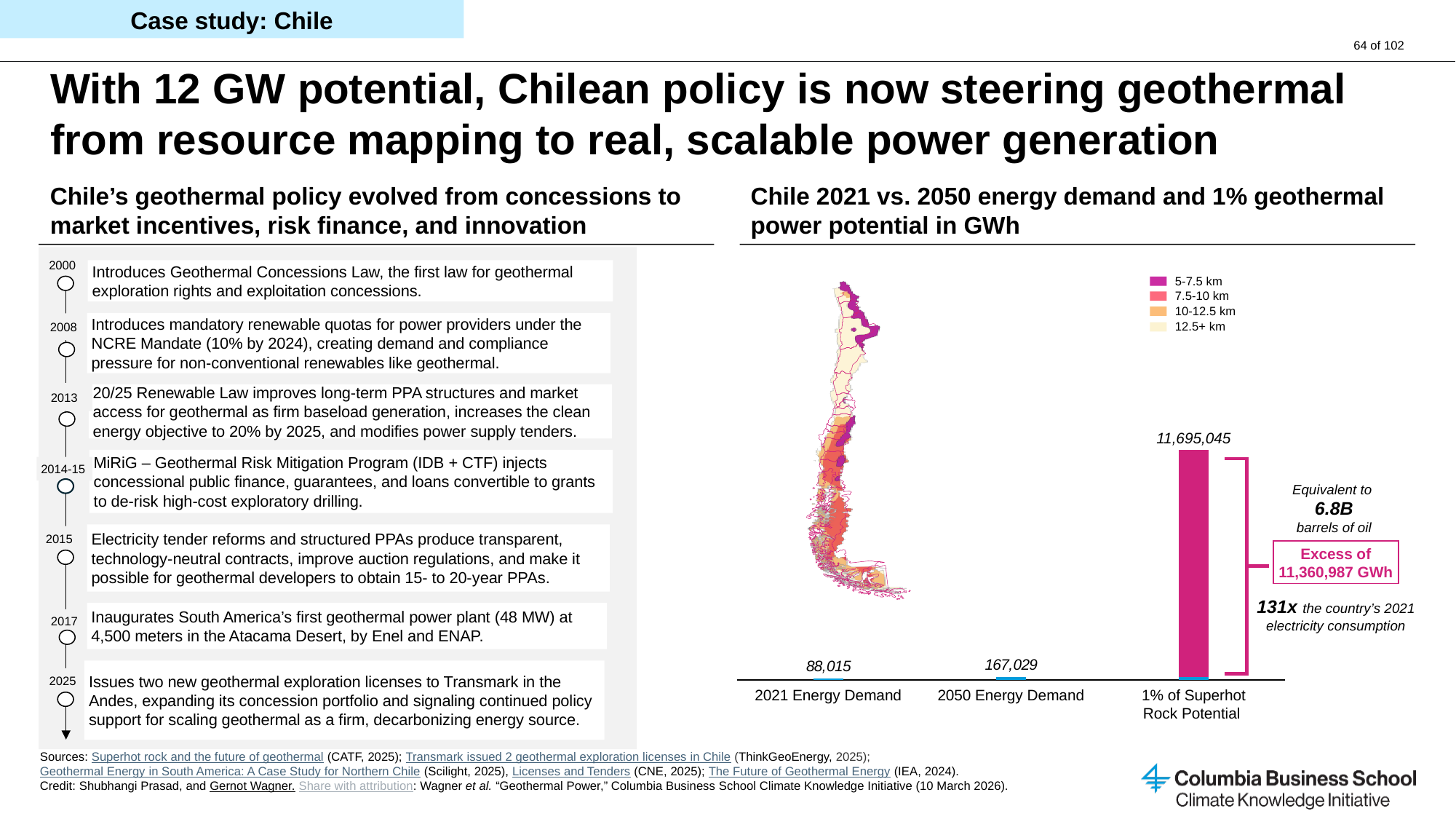
Which category has the lowest value in the bar chart? 2021 Energy Demand What is the value for 2021 Energy Demand in the bar chart? 88,015 What is the value for 1% of Superhot Rock Potential in the bar chart? 11,695,045 Do the values rise or fall moving left to right across the bar chart's categories? Rise How many categories are shown in the bar chart? 3 What is the value for 2050 Energy Demand in the bar chart? 167,029 According to the annotation, how many times the country's 2021 electricity consumption is the 1% superhot rock potential? 131x Which category has the highest value in the bar chart? 1% of Superhot Rock Potential What is the difference between the 2050 Energy Demand and the 2021 Energy Demand values? 79,014 Which is larger, the 2050 Energy Demand or the 2021 Energy Demand? 2050 Energy Demand According to the annotation on the bar chart, what is the excess of the 1% superhot rock potential in GWh? 11,360,987 GWh What kind of chart is used to show the energy demand and geothermal potential? Bar chart